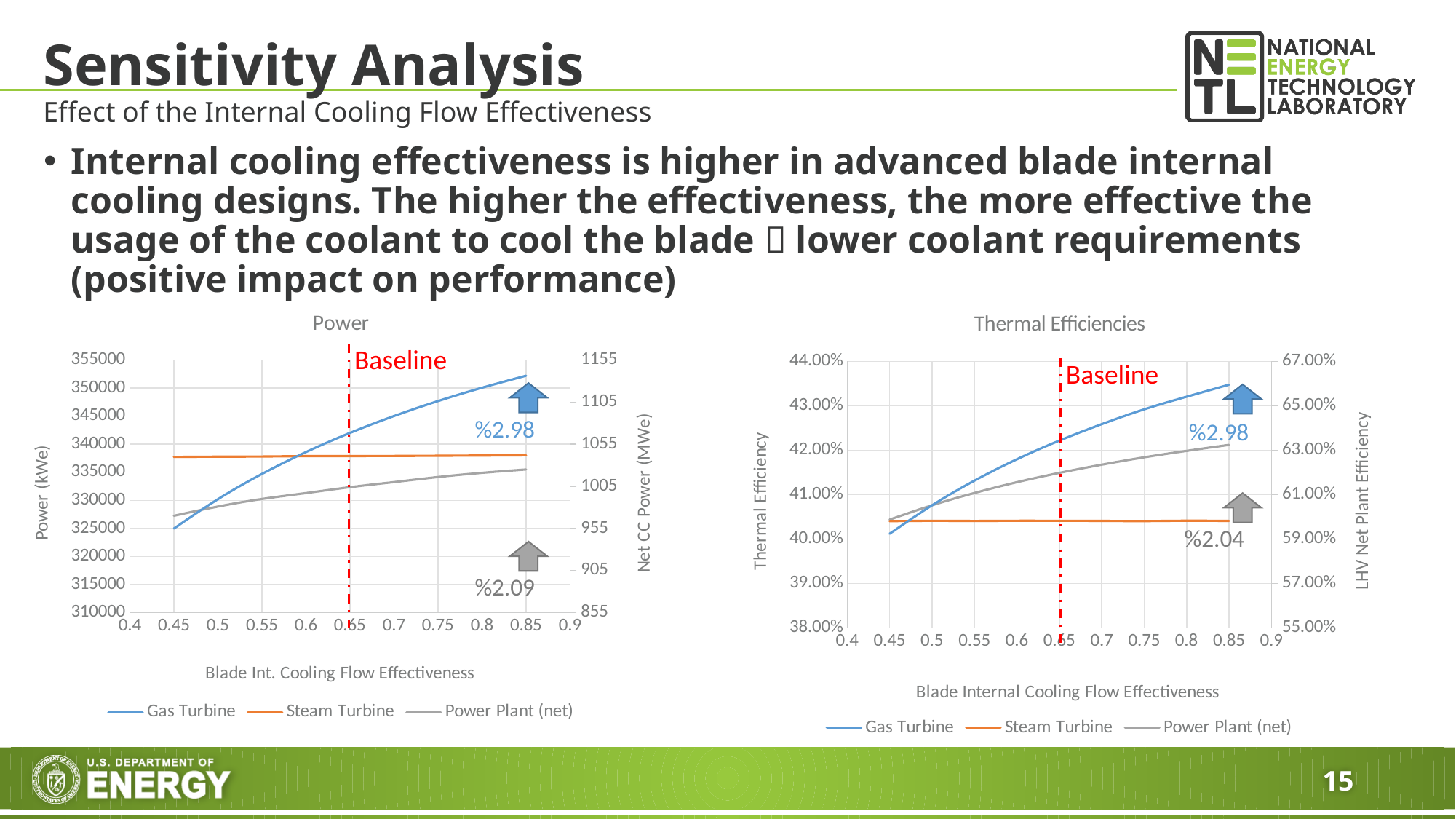
In the "Power" chart, is the Steam Turbine value greater or less than 340000? less In the "Power" chart, which is larger at 0.85 on the left axis: Gas Turbine or Steam Turbine? Gas Turbine In the "Power" chart, is the Gas Turbine value at 0.45 greater or less than 330000? less In the "Power" chart, does the Gas Turbine series rise or fall as Blade Int. Cooling Flow Effectiveness increases? rise What type of chart is the "Power" chart on the left? line chart In the "Thermal Efficiencies" chart, is the Gas Turbine value at 0.85 greater or less than 43.00%? greater What is the label of the right-hand y axis of the "Thermal Efficiencies" chart? LHV Net Plant Efficiency At what x-axis value is the Baseline marked in the "Power" chart? 0.65 In the "Thermal Efficiencies" chart, does the Steam Turbine series rise, fall, or stay flat across the x axis? stay flat How many series does the legend of the "Thermal Efficiencies" chart list? 3 In the "Thermal Efficiencies" chart, which is larger at 0.45 on the left axis: Gas Turbine or Steam Turbine? Steam Turbine